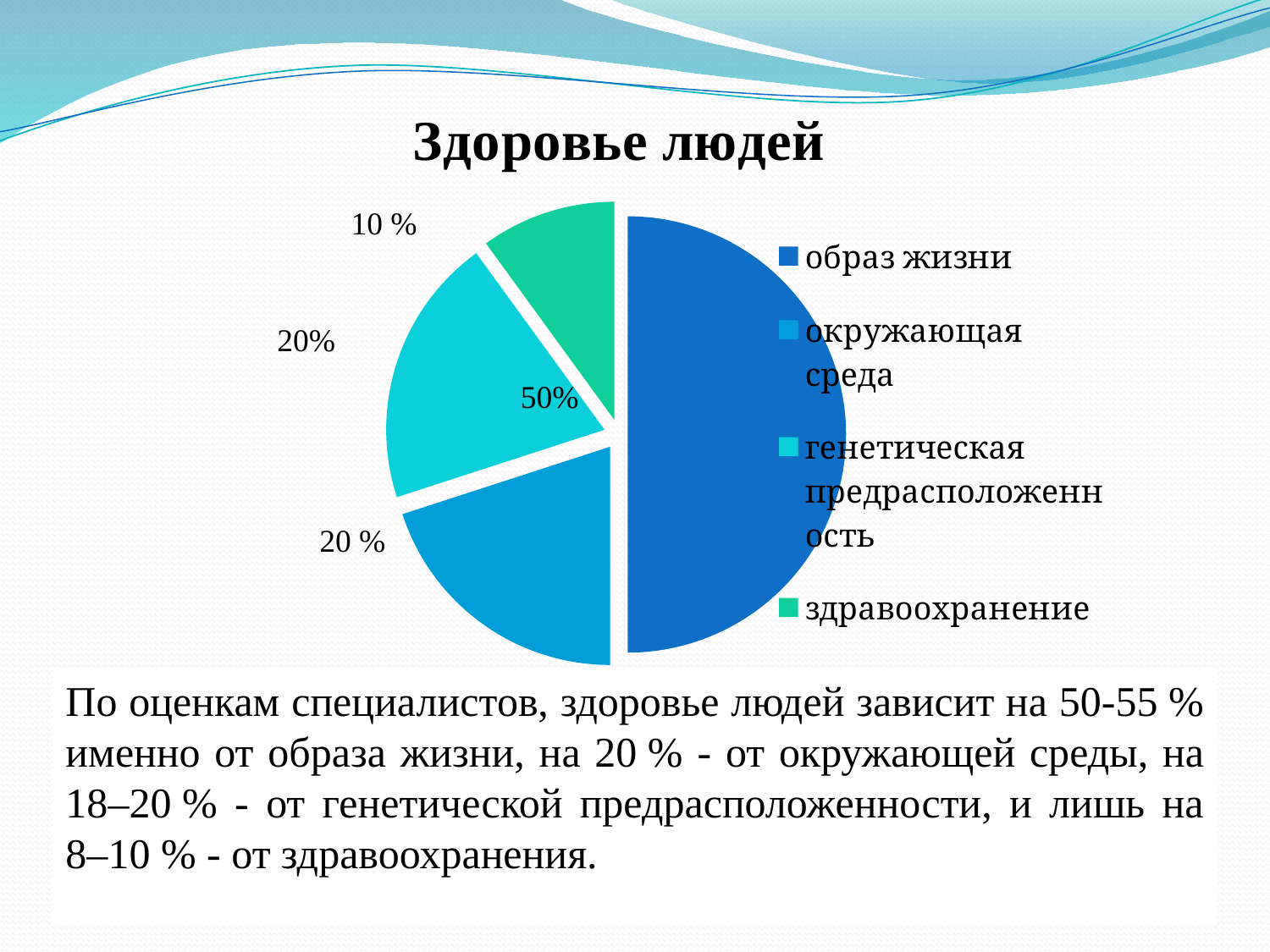
Which is larger, the slice for "образ жизни" or the slice for "здравоохранение"? образ жизни What is the title of the chart? Здоровье людей What kind of chart is shown on the slide? pie chart Which category has the smallest slice of the pie? здравоохранение How many slices does the pie chart have? 4 What is the value shown for "окружающая среда"? 20 % How many entries does the legend list? 4 What share of the pie does "образ жизни" take? 50% Which category has the largest slice of the pie? образ жизни What is the value shown for "здравоохранение"? 10 % What is the value shown for "генетическая предрасположенность"? 20% What is the difference in percentage points between "образ жизни" and "здравоохранение"? 40